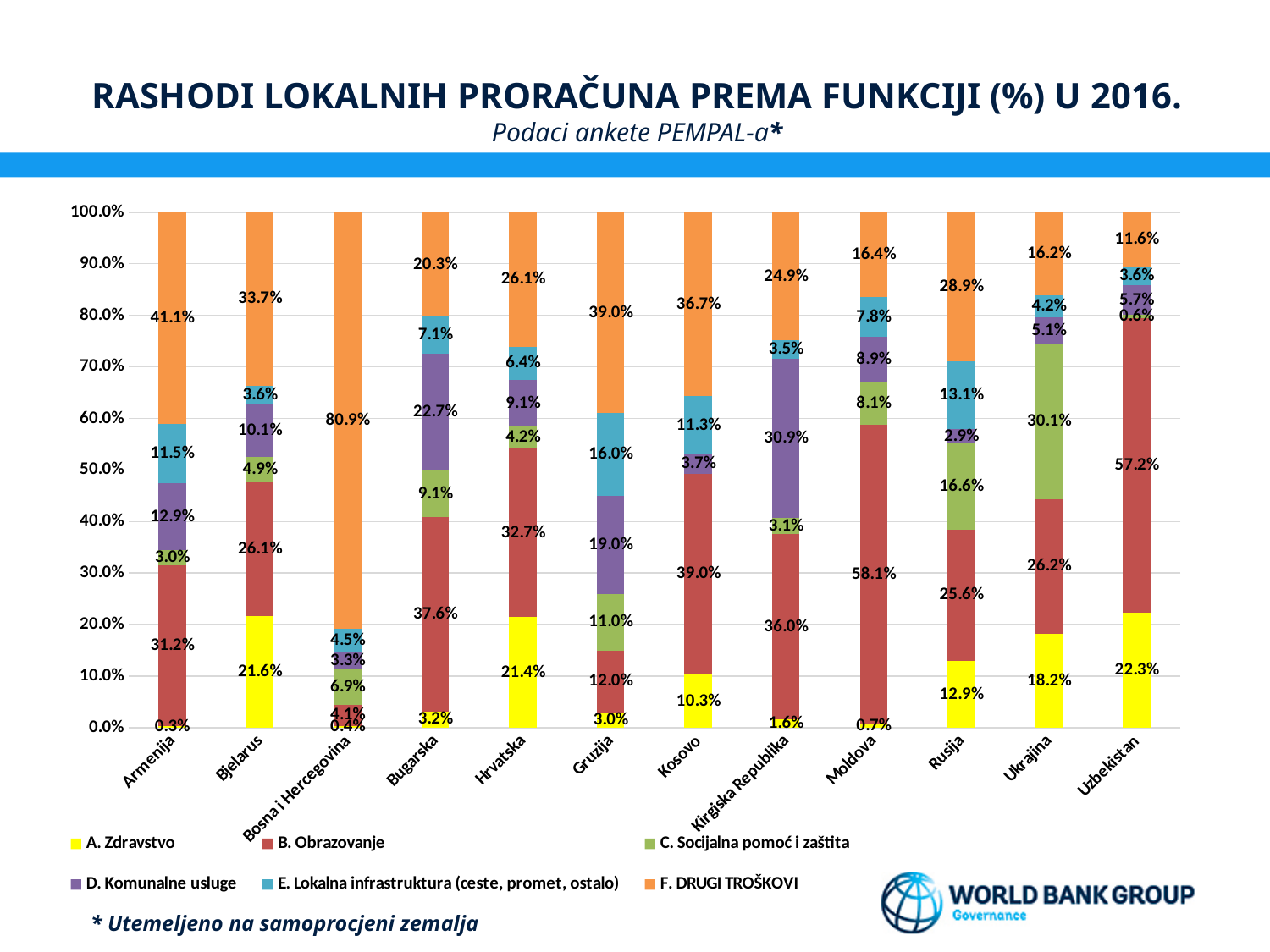
Which is larger: the D. Komunalne usluge value for Kirgiska Republika or for Bugarska? Kirgiska Republika Which country has the highest value for F. DRUGI TROŠKOVI? Bosna i Hercegovina What is the value of A. Zdravstvo for Uzbekistan? 22.3% How many countries are shown on the x axis of the chart? 12 What is the title of the chart on the slide? RASHODI LOKALNIH PRORAČUNA PREMA FUNKCIJI (%) U 2016. What is the value of B. Obrazovanje for Moldova? 58.1% What is the difference between the B. Obrazovanje values for Moldova and Uzbekistan? 0.9% What type of chart is shown on the slide? stacked bar chart Which country has the lowest value for A. Zdravstvo? Armenija How many series does the chart legend list? 6 What is the value of F. DRUGI TROŠKOVI for Bosna i Hercegovina? 80.9% What is the value of C. Socijalna pomoć i zaštita for Ukrajina? 30.1%